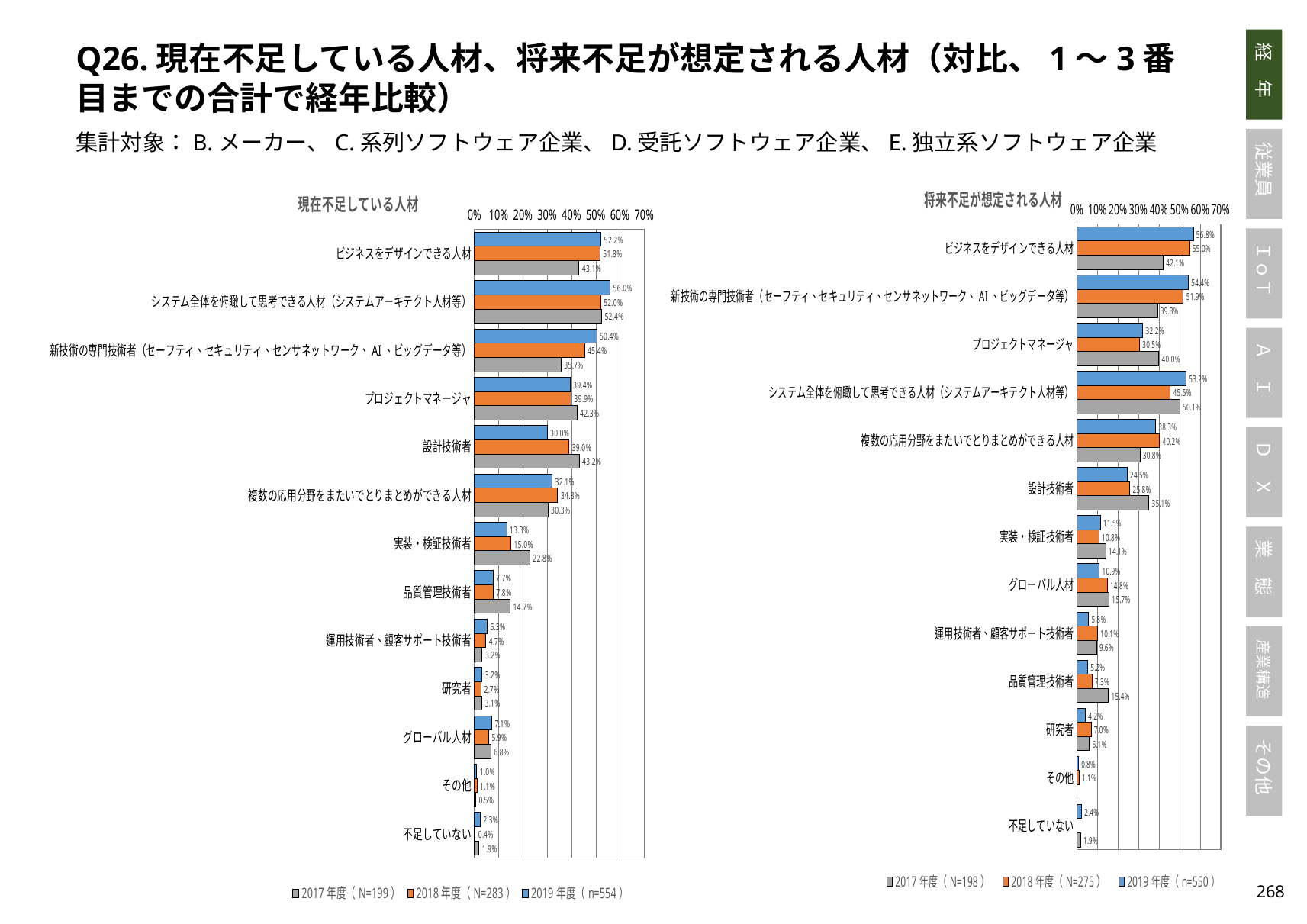
In the left chart (現在不足している人材), what is the 2017年度 value for 設計技術者? 43.2% How many categories are shown on the left chart (現在不足している人材)? 13 In the right chart (将来不足が想定される人材), what is the difference between the 2017年度 and 2019年度 values for 品質管理技術者? 10.2% In the left chart (現在不足している人材), what is the 2019年度 value for ビジネスをデザインできる人材? 52.2% In the left chart (現在不足している人材), which is larger for 実装・検証技術者: the 2017年度 value or the 2019年度 value? 2017年度 In the left chart (現在不足している人材), which category has the highest 2019年度 value? システム全体を俯瞰して思考できる人材（システムアーキテクト人材等） In the right chart (将来不足が想定される人材), which category has the highest 2019年度 value? ビジネスをデザインできる人材 In the right chart (将来不足が想定される人材), what is the 2018年度 value for 新技術の専門技術者? 51.9% How many series does the legend of the right chart (将来不足が想定される人材) list? 3 What kind of chart is the left chart (現在不足している人材)? Bar chart In the left chart (現在不足している人材), what is the difference between the 2019年度 and 2017年度 values for 新技術の専門技術者? 14.7% In the right chart (将来不足が想定される人材), what is the 2017年度 value for プロジェクトマネージャ? 40.0%